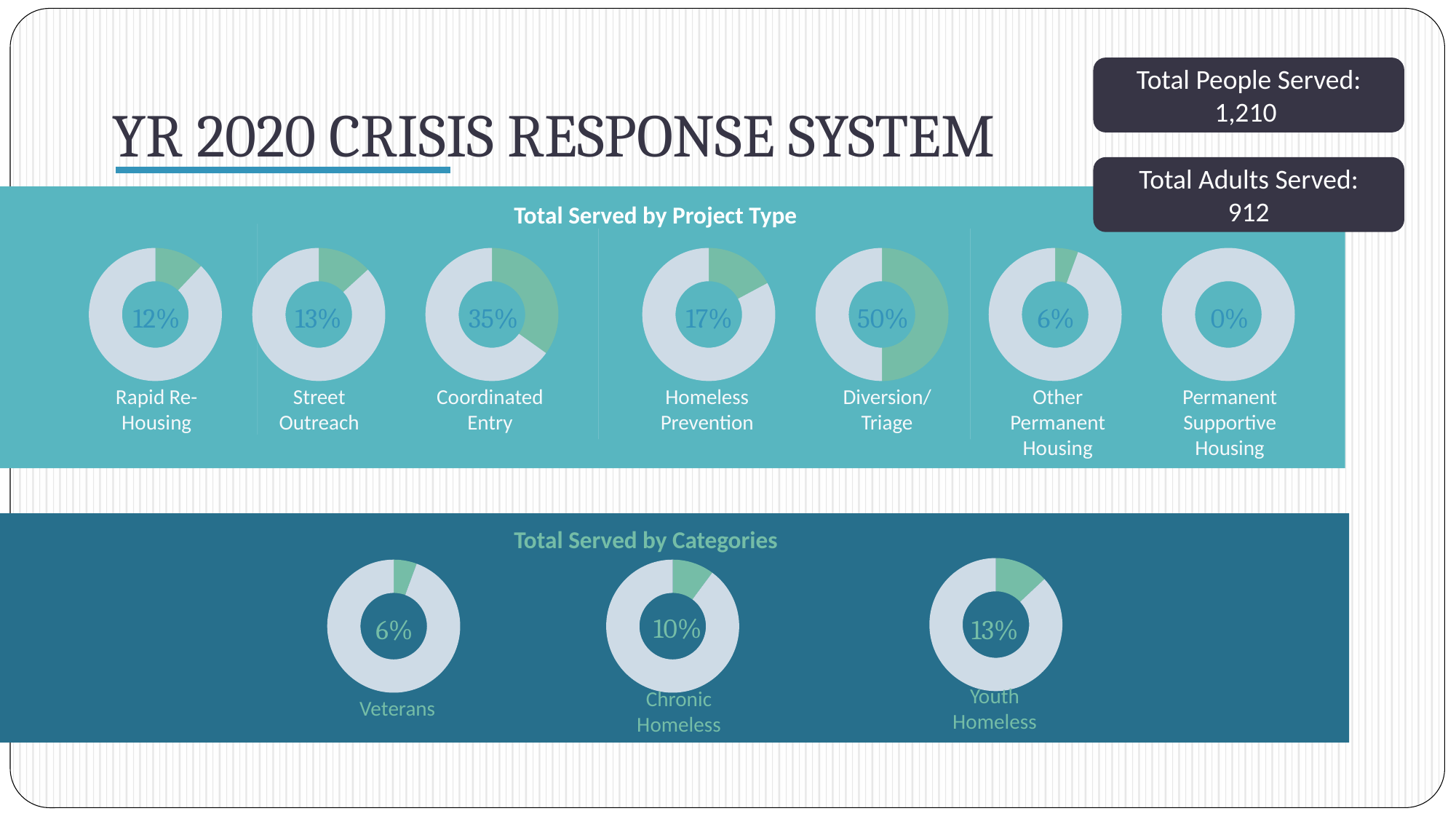
In the 'Total Served by Project Type' section, which is larger: Street Outreach or Rapid Re-Housing? Street Outreach How many donut charts are in the 'Total Served by Project Type' section? 7 In the 'Total Served by Project Type' section, what percentage is shown for Diversion/Triage? 50% In the 'Total Served by Categories' section, which category has the highest percentage? Youth Homeless In the 'Total Served by Project Type' section, what percentage is shown for Permanent Supportive Housing? 0% What kind of chart is used to show the percentages in the 'Total Served by Categories' section? Donut chart In the 'Total Served by Categories' section, what is the difference between the percentages for Youth Homeless and Veterans? 7% In the 'Total Served by Project Type' section, what is the difference between the percentages for Diversion/Triage and Homeless Prevention? 33% In the 'Total Served by Project Type' section, which project type has the lowest percentage? Permanent Supportive Housing In the 'Total Served by Categories' section, what percentage is shown for Chronic Homeless? 10% In the 'Total Served by Project Type' section, what percentage is shown for Coordinated Entry? 35% In the 'Total Served by Project Type' section, which project type has the highest percentage? Diversion/Triage